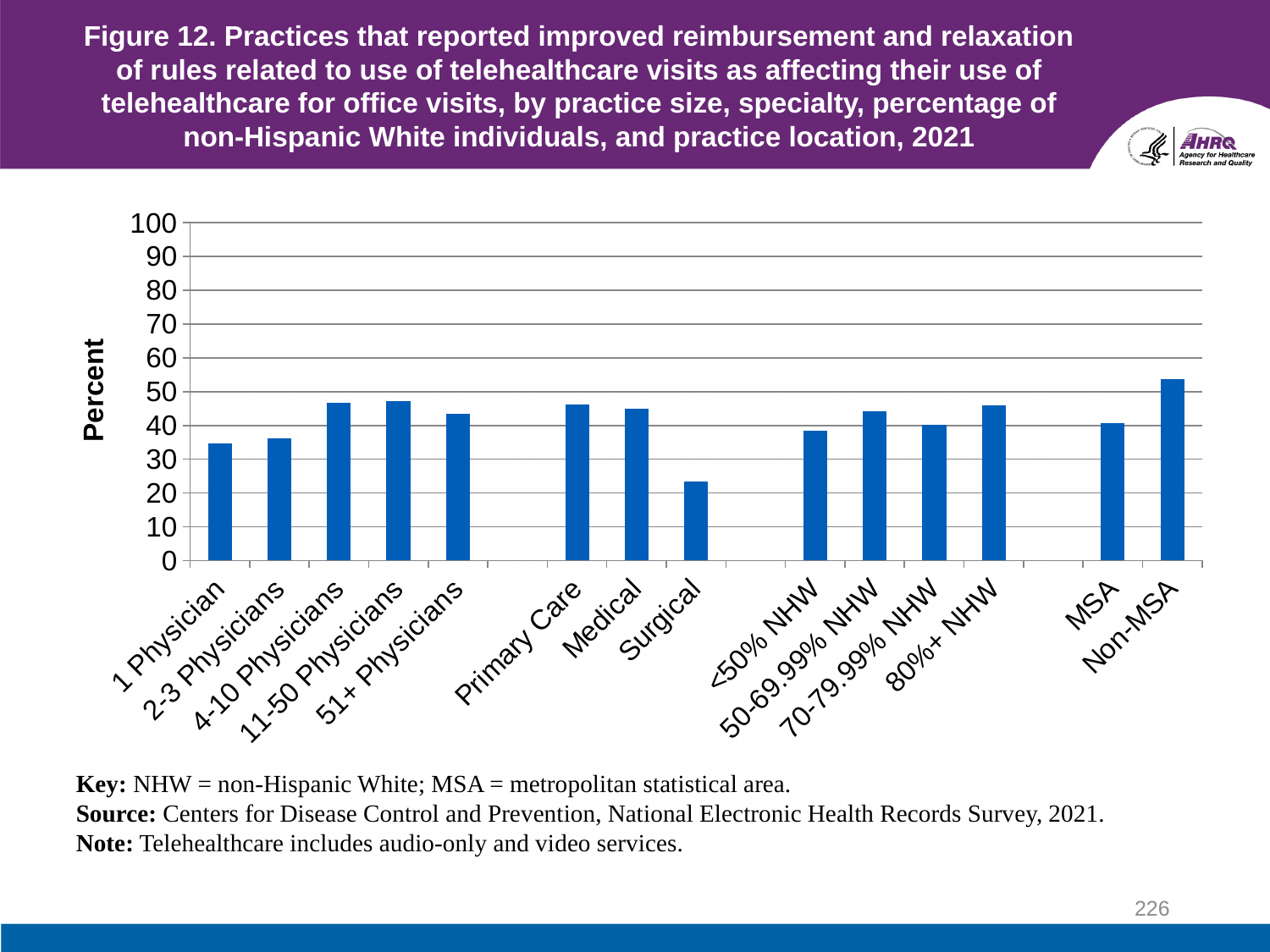
Which category has the lowest value in the chart? Surgical Is the value for 4-10 Physicians greater or less than 40? greater Is the value for MSA greater or less than 30? greater How many categories are plotted on the x axis of the chart? 14 Is the value for 1 Physician greater or less than 40? less Which is larger, the value for Primary Care or the value for Surgical? Primary Care What kind of chart is shown on the slide? bar chart Which is larger, the value for MSA or the value for Non-MSA? Non-MSA Which category has the highest value in the chart? Non-MSA What is the label on the vertical axis of the chart? Percent